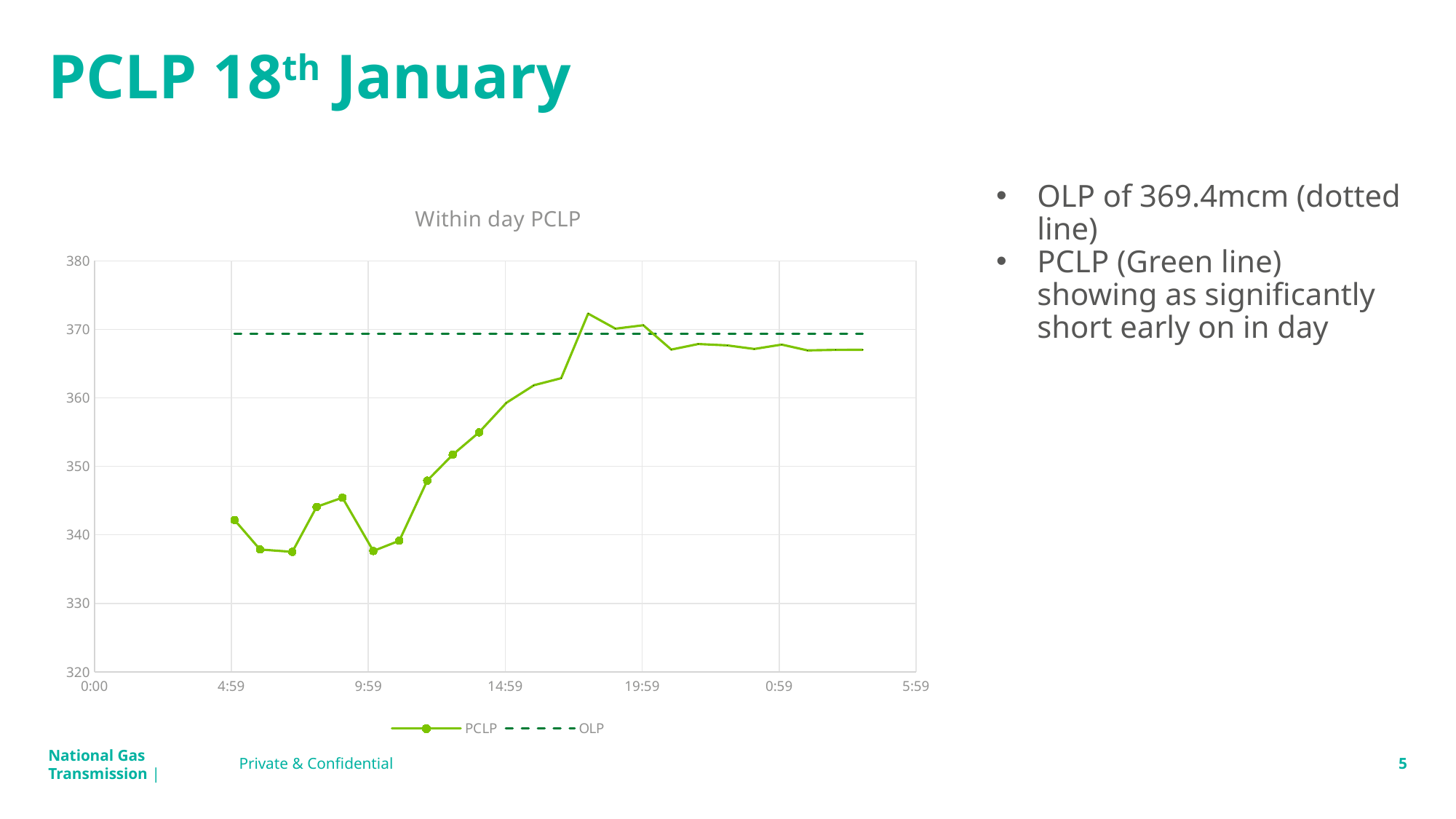
Is the PCLP value at 9:59 greater or less than 340? less What is the title of the chart? Within day PCLP What type of chart is shown on the slide? line chart How many series does the chart legend list? 2 Is the PCLP value at 4:59 greater or less than 340? greater How many time labels are shown on the x axis? 7 Does the PCLP line rise or fall between 9:59 and 14:59? rise What is the OLP value shown by the dotted line? 369.4mcm Which is larger, the PCLP value at 4:59 or at 9:59? 4:59 Which series is drawn as a dotted line? OLP Is the PCLP value at 0:59 greater or less than 370? less